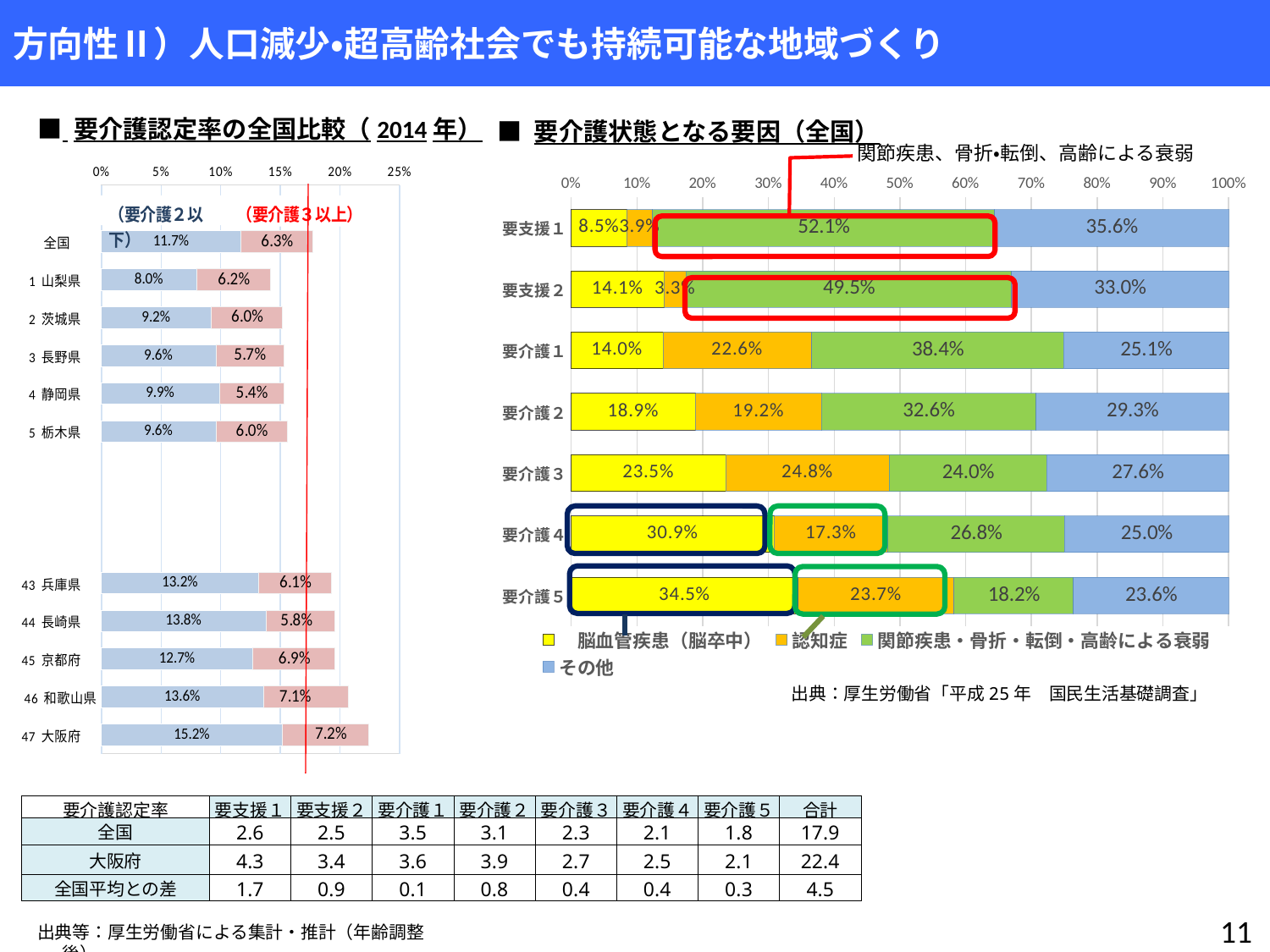
「要介護状態となる要因（全国）」のグラフには、いくつの区分（カテゴリ）が表示されていますか？ 7 「要介護認定率の全国比較（2014年）」のグラフはどの種類のグラフですか？ 積み上げ棒グラフ 「要介護認定率の全国比較（2014年）」のグラフで、全国の要介護2以下と要介護3以上の合計はいくつですか？ 18.0% 「要介護認定率の全国比較（2014年）」のグラフで、47 大阪府の要介護2以下の値はいくつですか？ 15.2% 「要介護状態となる要因（全国）」のグラフで、脳血管疾患（脳卒中）の割合が最も高い区分はどれですか？ 要介護5 「要介護状態となる要因（全国）」のグラフで、認知症の割合が最も低い区分はどれですか？ 要支援2 「要介護状態となる要因（全国）」のグラフの凡例には、いくつの系列がありますか？ 4 「要介護状態となる要因（全国）」のグラフで、要介護1の認知症と要介護2の認知症では、どちらの値が大きいですか？ 要介護1 「要介護状態となる要因（全国）」のグラフで、要介護5の脳血管疾患（脳卒中）の値はいくつですか？ 34.5% 「要介護状態となる要因（全国）」のグラフで、要介護4と要介護5の脳血管疾患（脳卒中）の値の差はいくつですか？ 3.6% 「要介護認定率の全国比較（2014年）」のグラフで、要介護3以上の値が最も高い都道府県はどれですか？ 47 大阪府 「要介護状態となる要因（全国）」のグラフで、要支援1の関節疾患・骨折・転倒・高齢による衰弱の値はいくつですか？ 52.1%